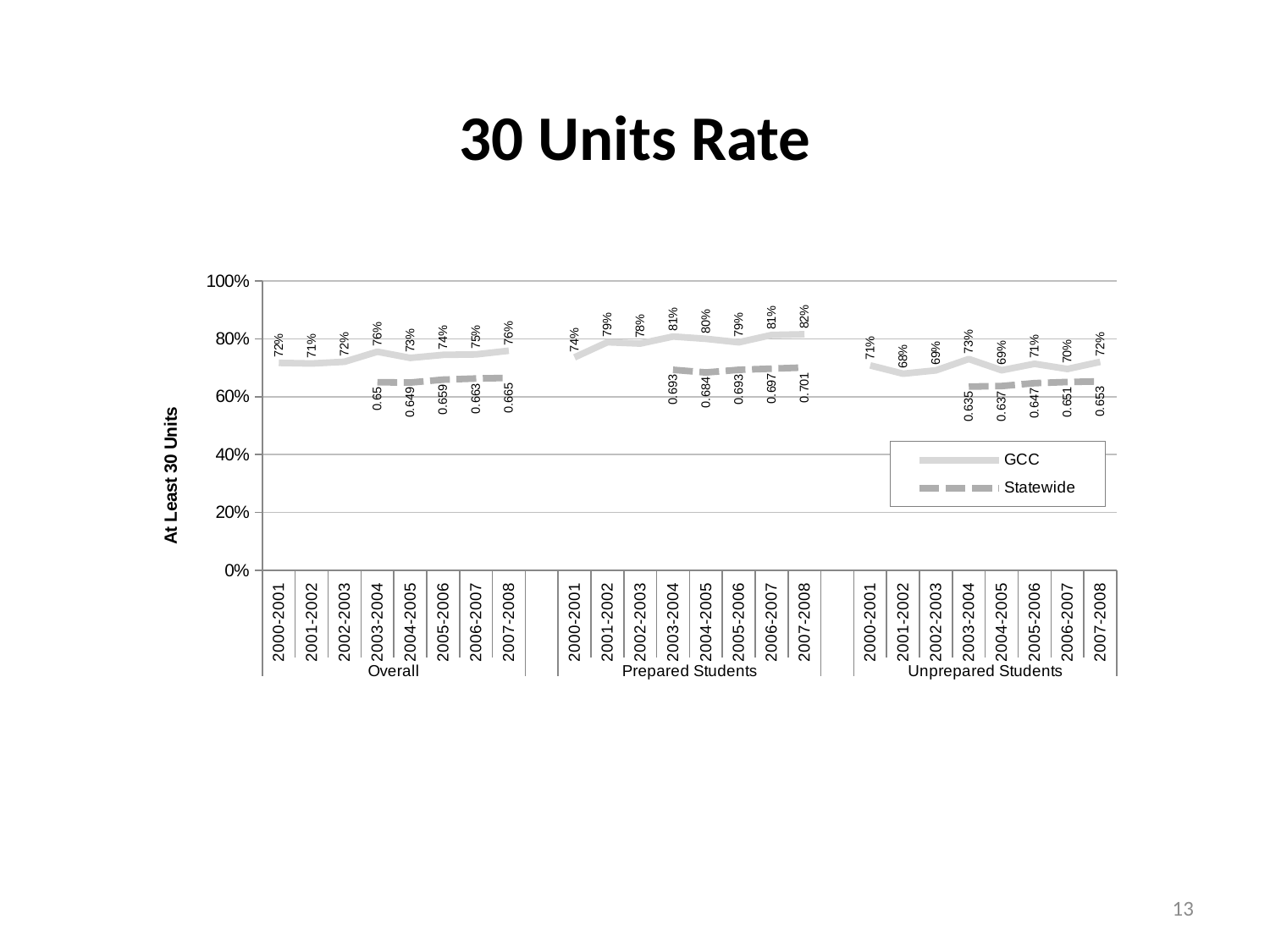
Which is larger, the GCC value for Overall in 2003-2004 or in 2004-2005? 2003-2004 What is the GCC value for Prepared Students in 2007-2008? 82% Which year has the lowest GCC value for Prepared Students? 2000-2001 What is the Statewide value for Prepared Students in 2004-2005? 0.684 How many series does the legend list? 2 What kind of chart is shown on the slide? Line chart What is the Statewide value for Unprepared Students in 2003-2004? 0.635 What is the label of the y axis? At Least 30 Units Which year has the highest GCC value for Unprepared Students? 2003-2004 What is the difference between the GCC values for Prepared Students and Unprepared Students in 2007-2008? 10% How many student groups are shown along the x axis? 3 What is the GCC value for Overall in 2001-2002? 71%